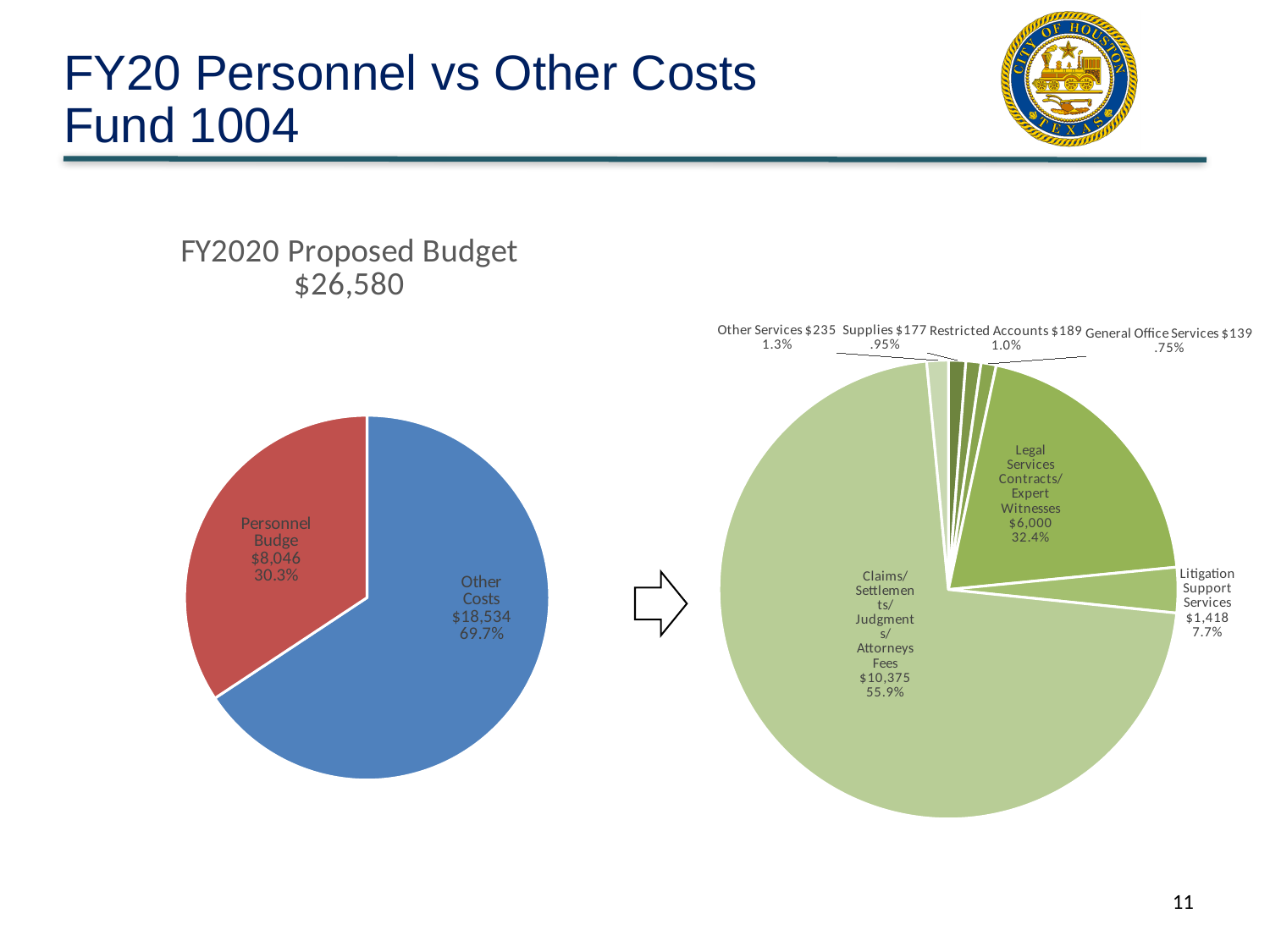
In the right pie chart, what is the difference between Other Services and Supplies? $58 In the right pie chart, how many categories are shown? 7 In the left pie chart titled FY2020 Proposed Budget, what share of the pie is the Personnel Budge slice? 30.3% In the right pie chart, what is the value for Legal Services Contracts/Expert Witnesses? $6,000 In the left pie chart titled FY2020 Proposed Budget, what is the difference between Other Costs and Personnel Budge? $10,488 In the left pie chart titled FY2020 Proposed Budget, what is the value for Other Costs? $18,534 What kind of chart is the chart on the right side of the slide? Pie chart In the right pie chart, which category has the smallest slice? General Office Services In the right pie chart, which category has the largest slice? Claims/Settlements/Judgments/Attorneys Fees In the right pie chart, what share of the pie is Litigation Support Services? 7.7% What total budget amount is shown in the title of the left pie chart? $26,580 In the left pie chart titled FY2020 Proposed Budget, which slice is larger, Personnel Budge or Other Costs? Other Costs